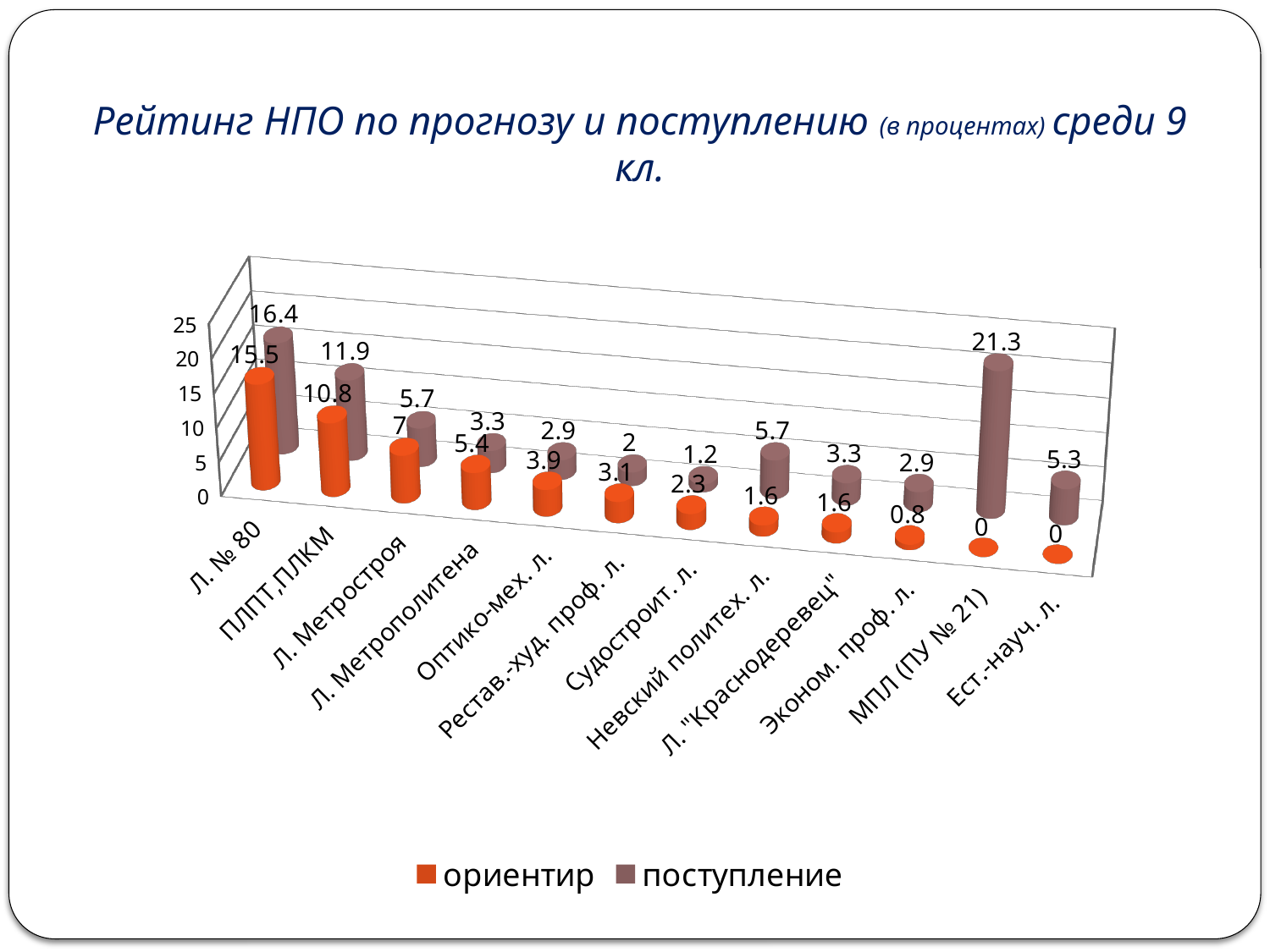
How many categories are shown on the x axis? 12 Which category has the highest поступление value? МПЛ (ПУ № 21) For Л. Метростроя, which is larger: ориентир or поступление? ориентир What is the поступление value for МПЛ (ПУ № 21)? 21.3 Which category has the highest ориентир value? Л. № 80 What is the ориентир value for Ест.-науч. л.? 0 What kind of chart is shown on the slide? bar chart What is the ориентир value for Л. № 80? 15.5 How many series does the legend list? 2 What is the поступление value for Невский политех. л.? 5.7 Is the поступление value for МПЛ (ПУ № 21) greater or less than 20? greater What is the difference between the поступление and ориентир values for ПЛПТ,ПЛКМ? 1.1